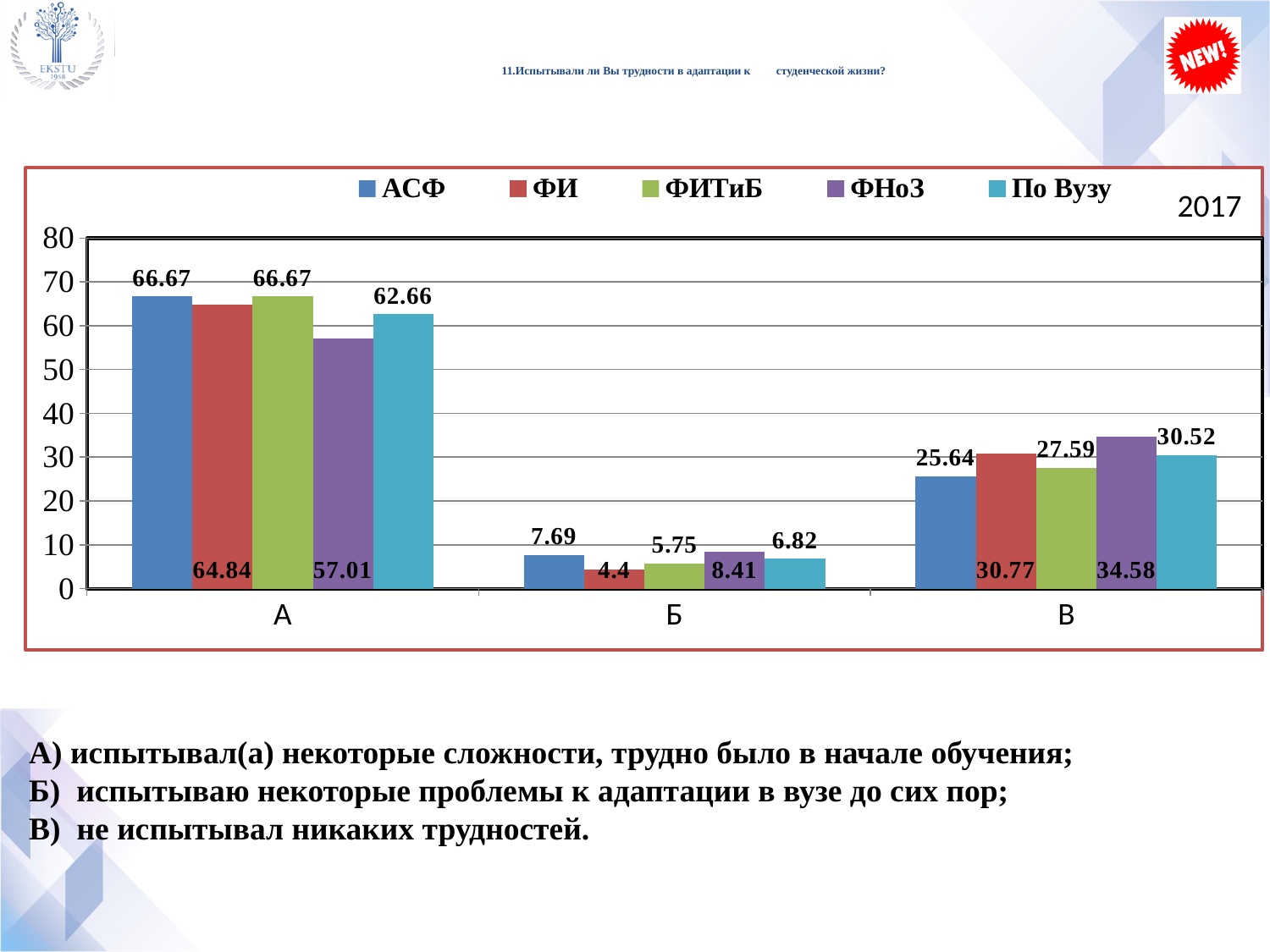
What is the value for АСФ in category В? 25.64 Which series has the highest value in category В? ФНоЗ How many series does the legend list? 5 What is the value for ФИ in category А? 64.84 What is the difference between the ФНоЗ and АСФ values in category В? 8.94 What is the value for ФНоЗ in category Б? 8.41 What year is shown in the top right corner of the chart? 2017 Which is larger in category А: the value for ФНоЗ or the value for По Вузу? По Вузу Which series has the lowest value in category Б? ФИ What is the value for По Вузу in category В? 30.52 How many categories are shown on the x axis? 3 What kind of chart is shown on the slide? bar chart